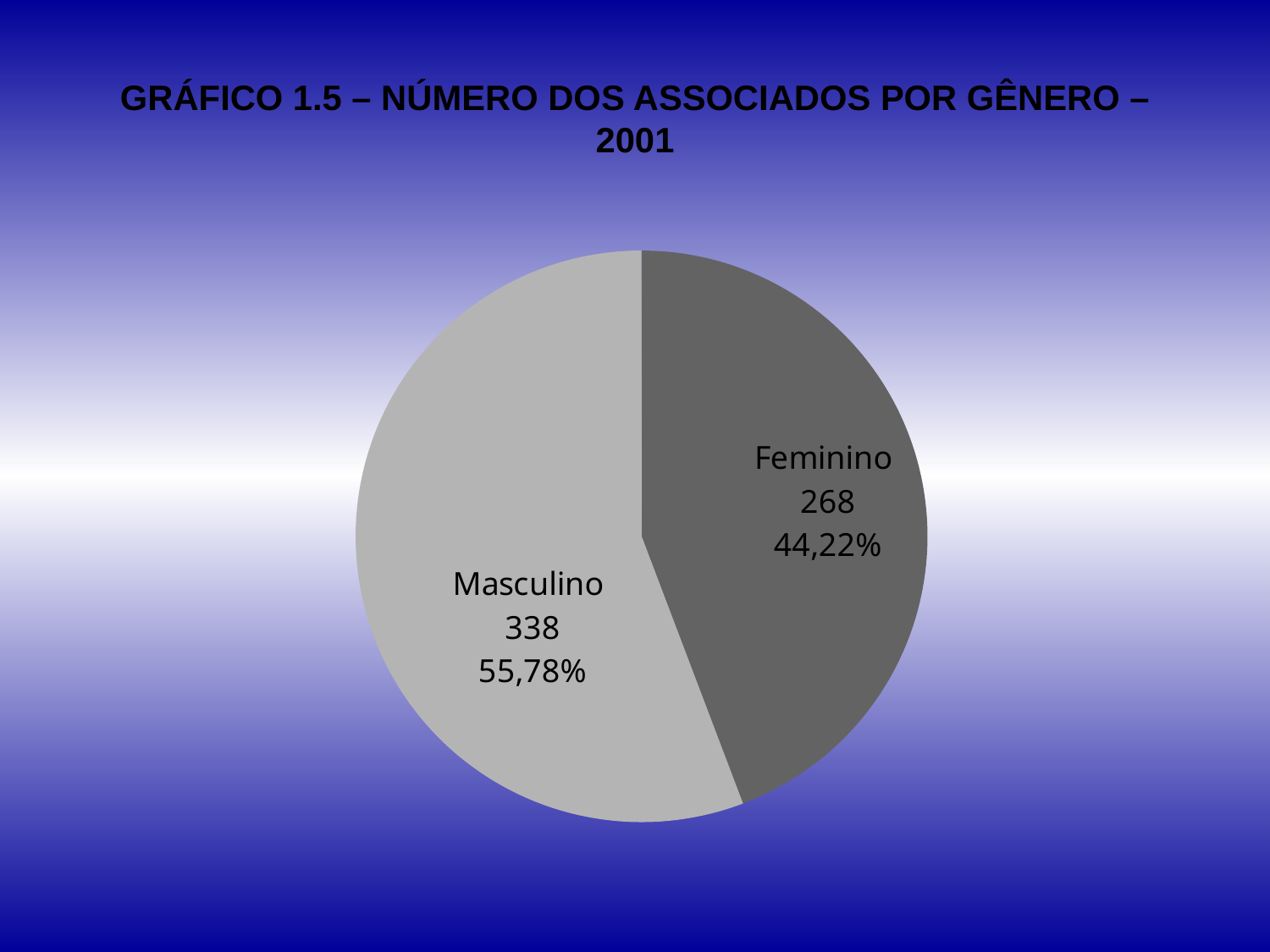
What type of chart is shown on the slide? Pie chart What share of the pie does the Feminino slice represent? 44,22% How many associates are in the Feminino category? 268 How many associates are in the Masculino category? 338 Which is larger, the Masculino value or the Feminino value? Masculino What is the difference between the number of Masculino and Feminino associates? 70 What is the title of the chart? GRÁFICO 1.5 – NÚMERO DOS ASSOCIADOS POR GÊNERO – 2001 Which category has the smallest slice? Feminino What share of the pie does the Masculino slice represent? 55,78% How many categories does the pie chart show? 2 Which category has the largest slice? Masculino What is the total number of associates shown in the pie chart? 606